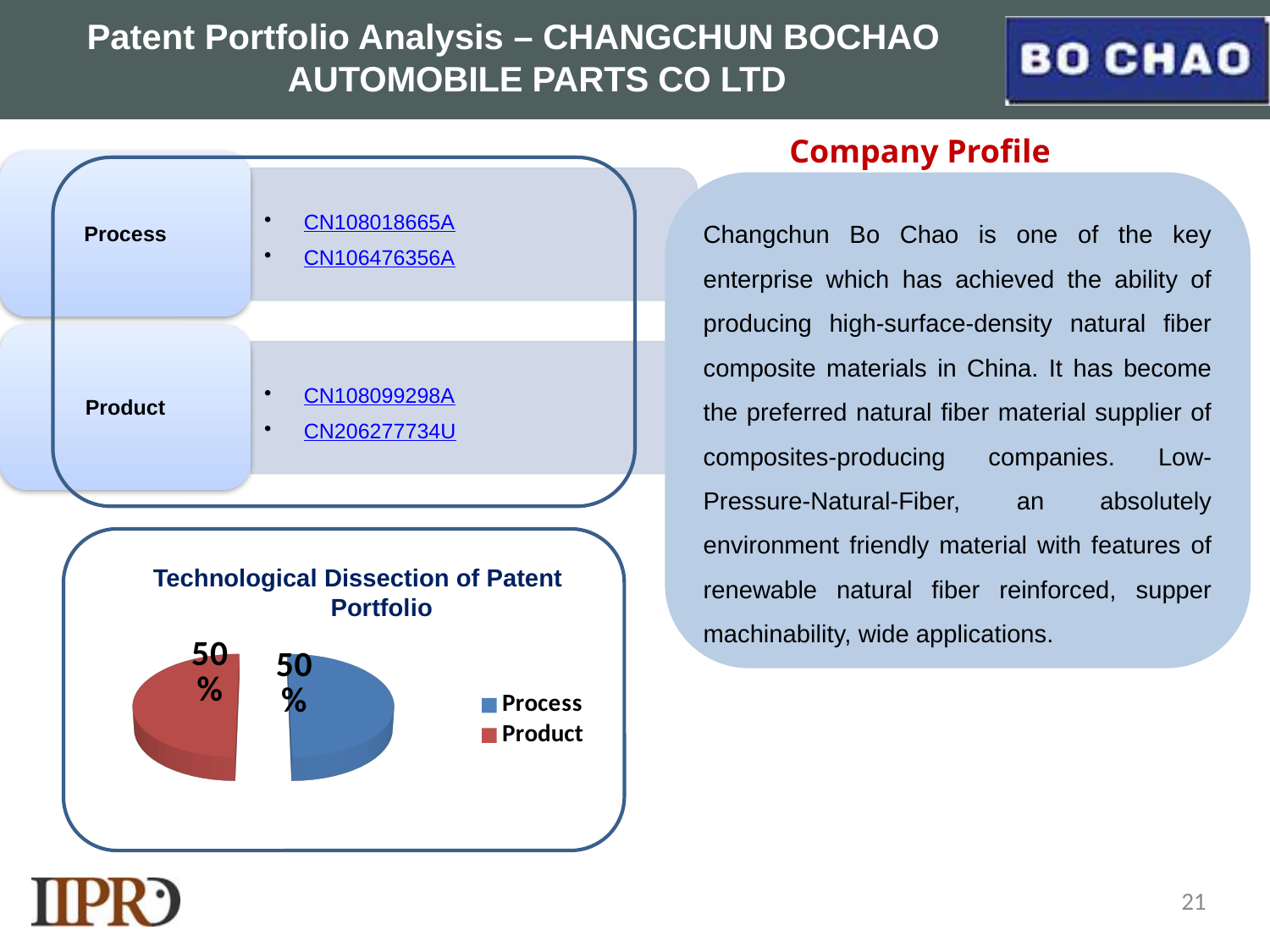
What share of the pie chart does the Process slice represent? 50% What is the title of the chart on the slide? Technological Dissection of Patent Portfolio What do the Process and Product slices of the pie chart add up to? 100% What share of the pie chart does the Product slice represent? 50% What value is labelled on the Product slice of the pie chart? 50% How many slices does the pie chart have? 2 What is the difference between the Process and Product shares in the pie chart? 0% What kind of chart is shown under the title "Technological Dissection of Patent Portfolio"? pie chart How many entries does the legend of the pie chart list? 2 What value is labelled on the Process slice of the pie chart? 50% Which colour represents Process in the pie chart? blue